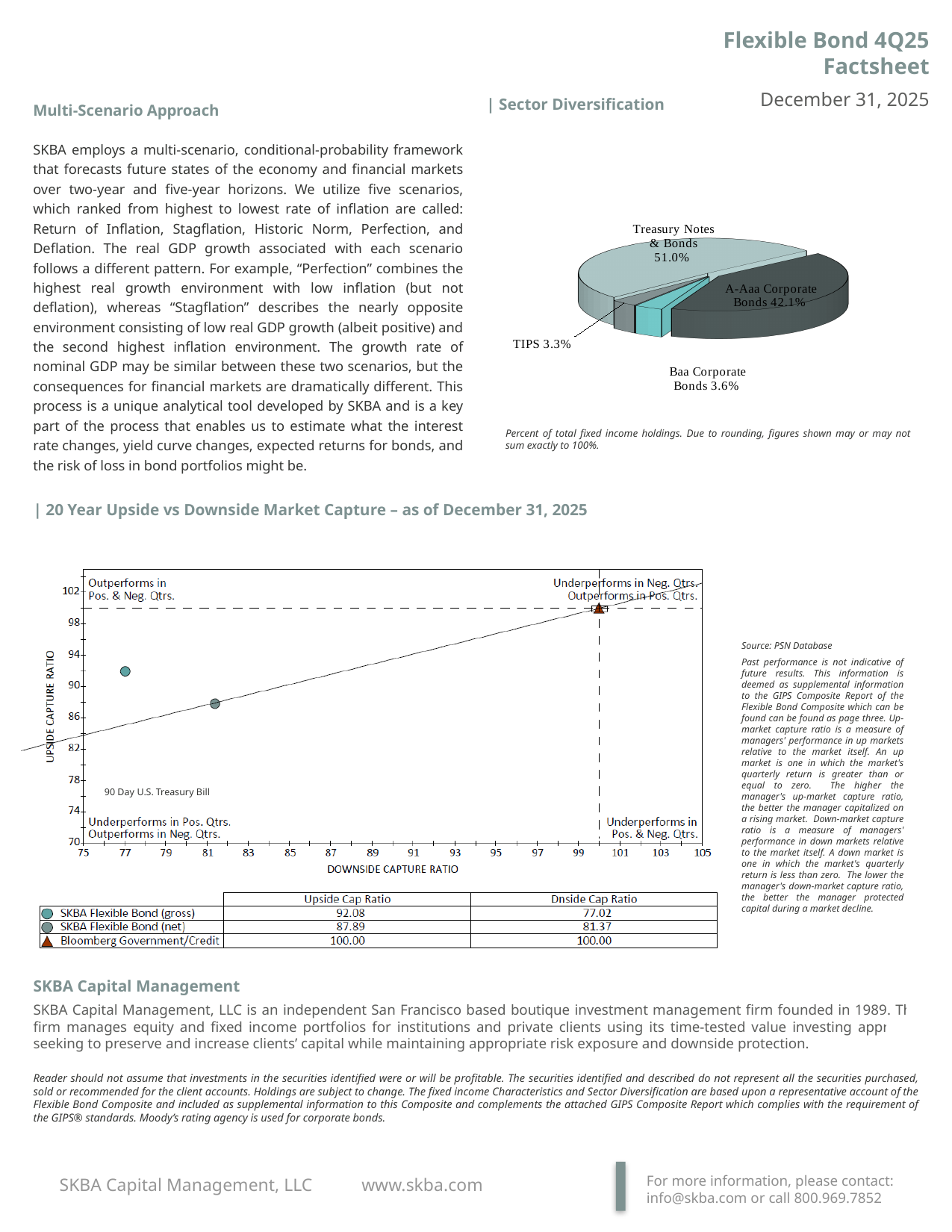
What kind of chart is the Sector Diversification chart? Pie chart In the Sector Diversification pie chart, what share of holdings is A-Aaa Corporate Bonds? 42.1% In the Sector Diversification pie chart, what is the difference in percentage points between Treasury Notes & Bonds and A-Aaa Corporate Bonds? 8.9 In the Sector Diversification pie chart, which category has the smallest share? TIPS In the 20 Year Upside vs Downside Market Capture chart, what is the Dnside Cap Ratio for SKBA Flexible Bond (net)? 81.37 In the Sector Diversification pie chart, what share of holdings is Treasury Notes & Bonds? 51.0% In the 20 Year Upside vs Downside Market Capture chart, which series has the lowest Downside Capture Ratio? SKBA Flexible Bond (gross) In the Sector Diversification pie chart, how many slices are shown? 4 In the 20 Year Upside vs Downside Market Capture chart, how many series are listed in the table below the chart? 3 In the Sector Diversification pie chart, which category has the largest share? Treasury Notes & Bonds In the 20 Year Upside vs Downside Market Capture chart, what is the Upside Cap Ratio for SKBA Flexible Bond (gross)? 92.08 In the 20 Year Upside vs Downside Market Capture chart, what is the difference between the Upside Cap Ratio of SKBA Flexible Bond (gross) and SKBA Flexible Bond (net)? 4.19